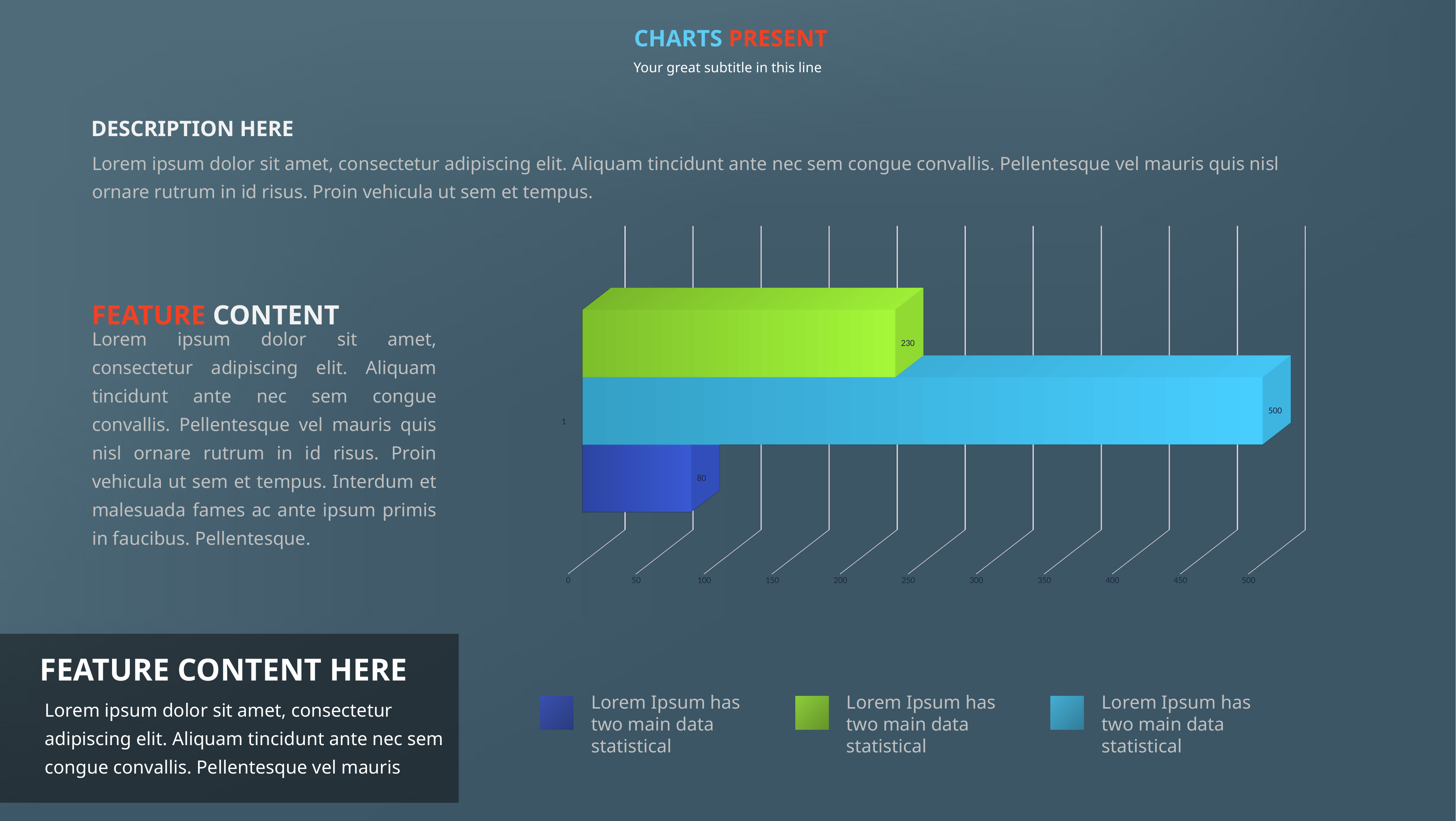
What is the value of the dark blue bar? 80 How many series does the legend list? 3 Which is larger, the green bar or the dark blue bar? the green bar What is the difference between the light blue bar and the green bar? 270 What is the maximum value shown on the horizontal axis? 500 What is the difference between the green bar and the dark blue bar? 150 Which bar has the highest value? the light blue bar (500) What is the value of the green bar? 230 What kind of chart is shown on the slide? bar chart What is the value of the light blue bar? 500 How many bars are plotted on the chart? 3 Which bar has the lowest value? the dark blue bar (80)